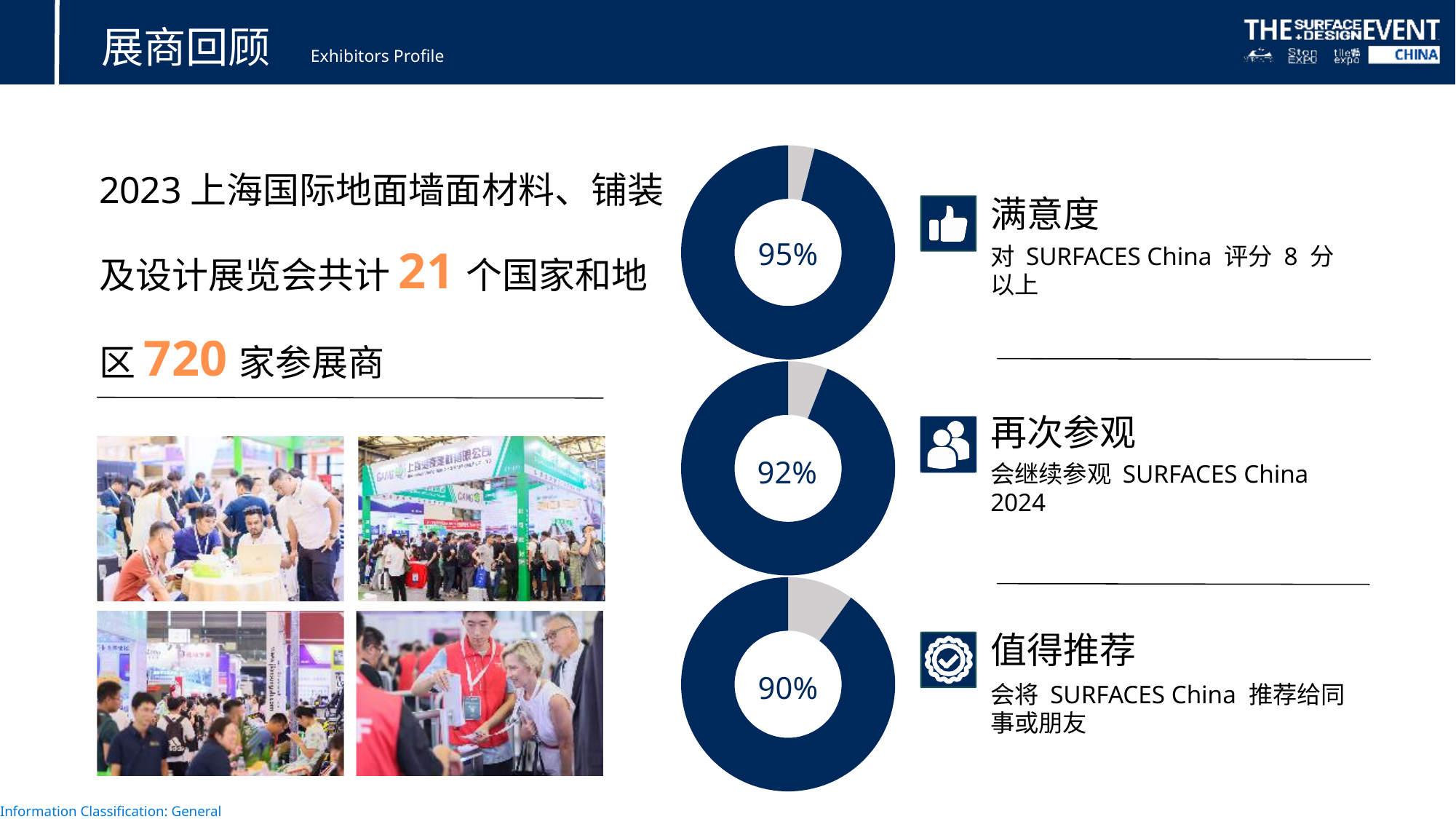
Which is larger: the percentage in the middle donut chart or the percentage in the bottom donut chart? The middle donut chart (92%) What is the difference between the percentage in the top donut chart and the percentage in the middle donut chart? 3% In the bottom donut chart, what share of the ring is not filled with dark blue? 10% What is the difference between the percentage in the top donut chart and the percentage in the bottom donut chart? 5% What colour is the filled portion of each donut chart? Dark blue What percentage is shown in the bottom donut chart (next to 值得推荐)? 90% Which of the three donut charts shows the highest percentage? The top one (满意度), 95% What percentage is shown in the middle donut chart (next to 再次参观)? 92% What percentage is shown in the top donut chart (next to 满意度)? 95% What type of chart is used to display the 95%, 92% and 90% figures? Donut (pie) chart How many donut charts are on the slide? 3 Which of the three donut charts shows the lowest percentage? The bottom one (值得推荐), 90%